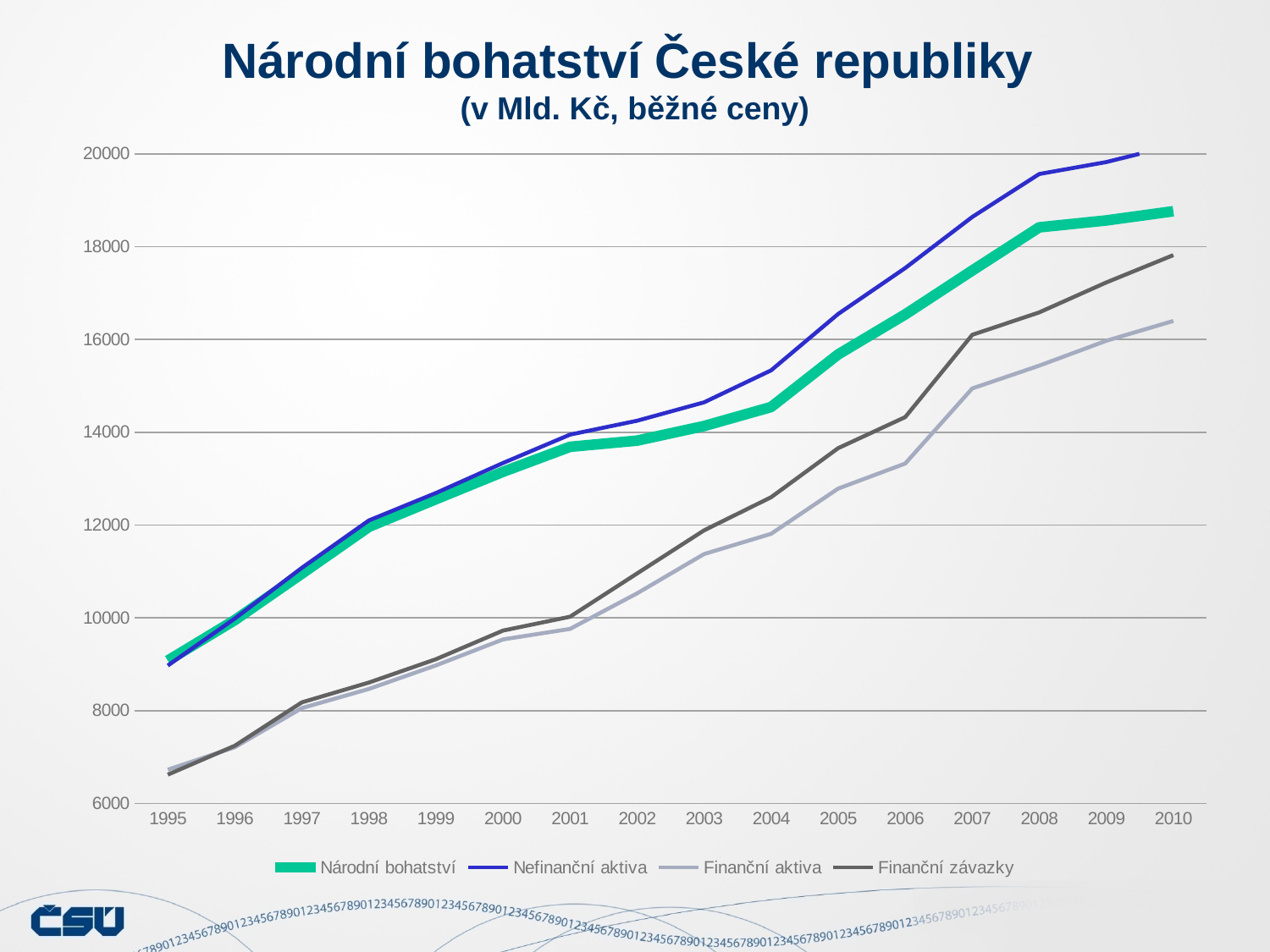
What kind of chart is shown on the slide? line chart Does the Národní bohatství series rise or fall from 1995 to 2010? rise Is the value for Národní bohatství in 2010 greater or less than 18000? greater Which series has the lowest value in 2010? Finanční aktiva Is the value for Národní bohatství in 2005 greater or less than 16000? less Which series has the highest value in 2010? Nefinanční aktiva Is the value for Finanční aktiva in 1995 greater or less than 6000? greater How many series does the legend list? 4 How many years are shown on the x axis? 16 In 2010, which is larger: Finanční závazky or Finanční aktiva? Finanční závazky What is the title of the chart? Národní bohatství České republiky (v Mld. Kč, běžné ceny)